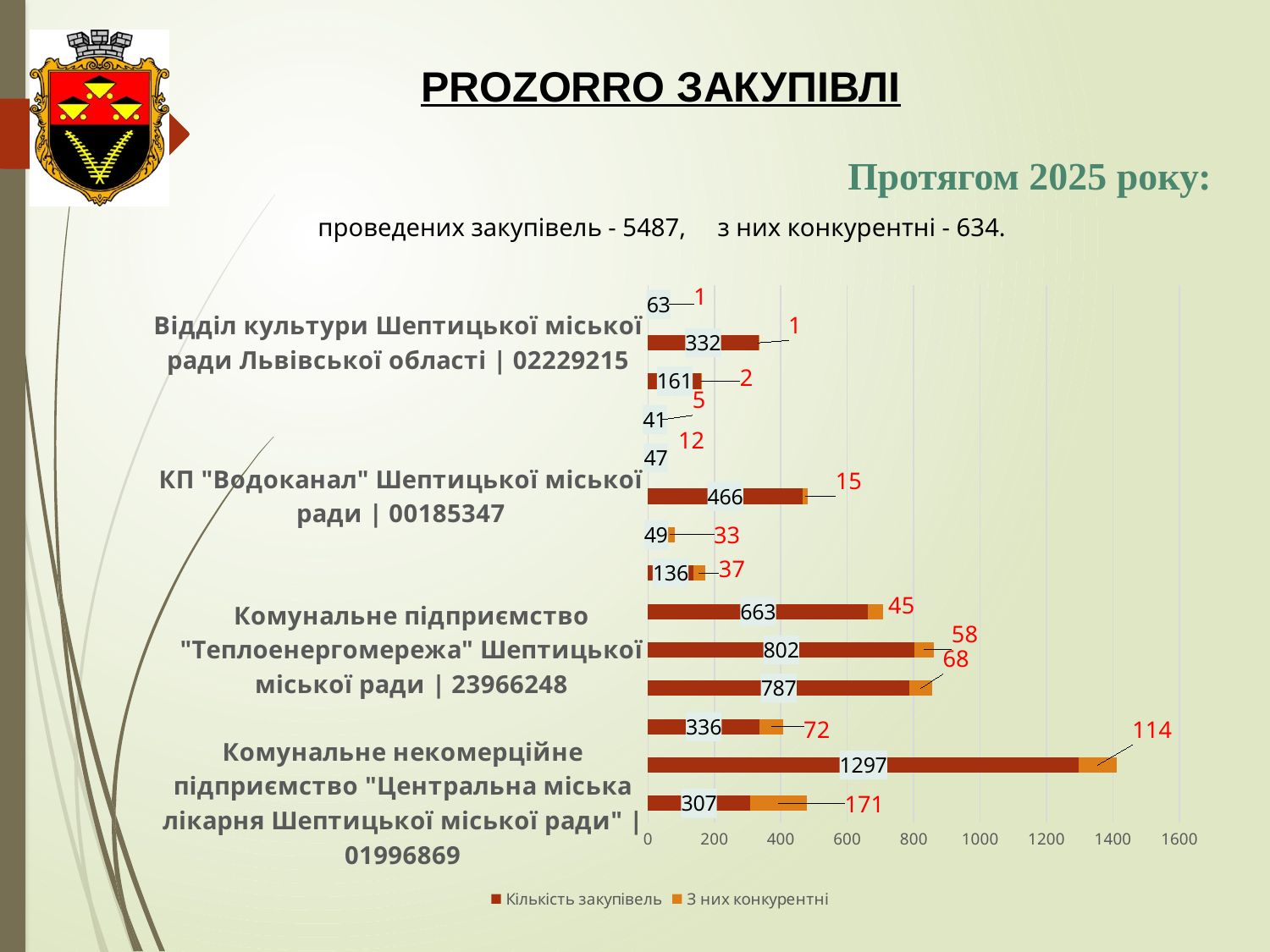
What is the total of the stacked bar with 'Кількість закупівель' 1297 and 'З них конкурентні' 114? 1411 What is the difference between the largest 'Кількість закупівель' value (1297) and the value 802? 495 What kind of chart is shown on the slide? bar chart How many bars are plotted in the chart? 14 What is the highest value of the 'Кількість закупівель' series? 1297 What are the two legend entries of the chart? Кількість закупівель; З них конкурентні Which is larger among the 'Кількість закупівель' values 663 and 787? 787 What is the highest value of the 'З них конкурентні' series? 171 What is the 'З них конкурентні' value for Комунальне підприємство "Теплоенергомережа" Шептицької міської ради | 23966248? 58 How many series does the legend list? 2 What is the 'Кількість закупівель' value for КП "Водоканал" Шептицької міської ради | 00185347? 466 What is the lowest value of the 'Кількість закупівель' series? 41